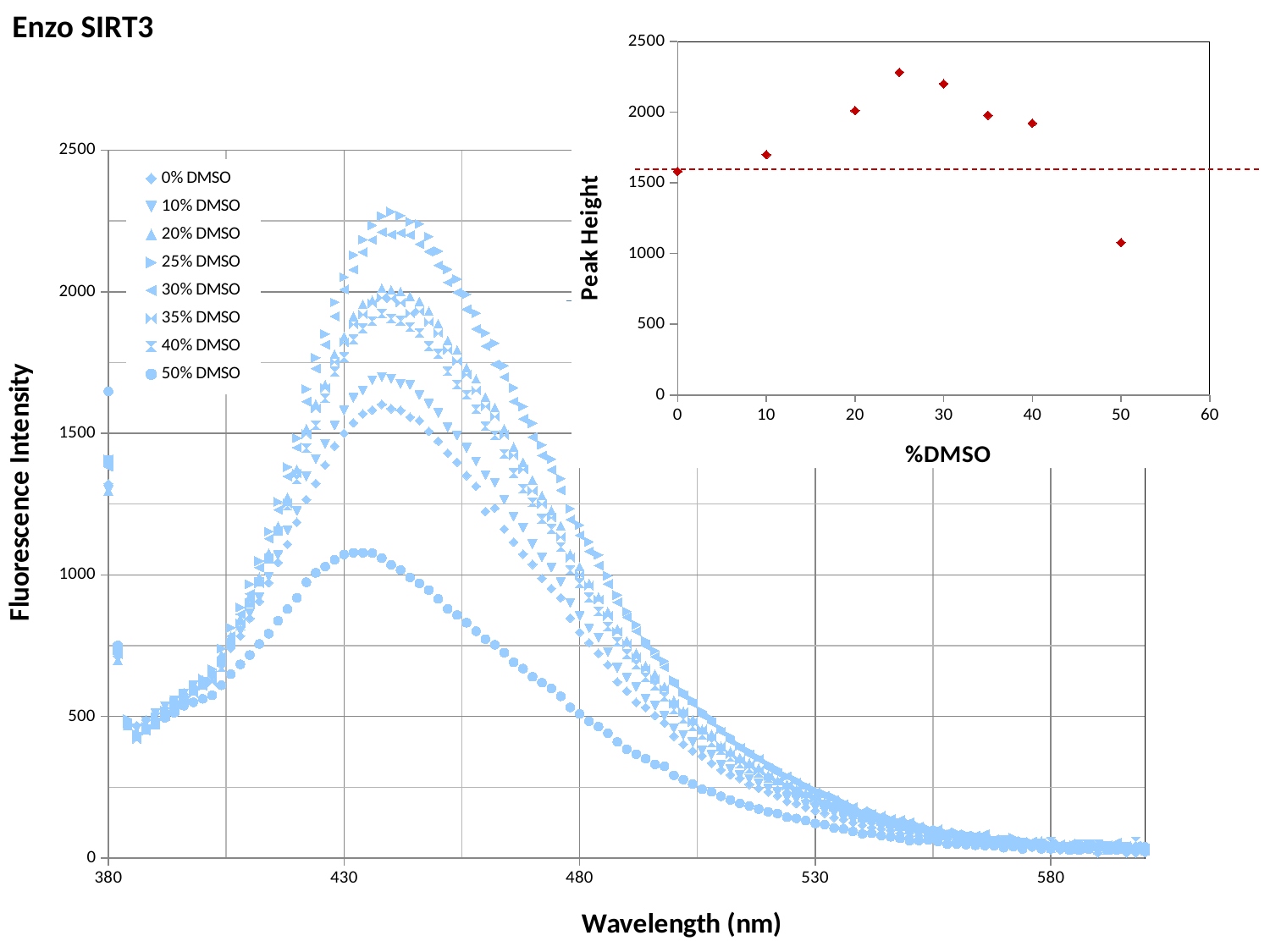
In the large fluorescence chart, which series has the lowest peak fluorescence intensity? 50% DMSO In the inset chart of Peak Height versus %DMSO, is the peak height at 25% DMSO greater or less than 2000? greater In the inset chart of Peak Height versus %DMSO, is the peak height at 50% DMSO greater or less than 1500? less In the inset chart of Peak Height versus %DMSO, which has the larger peak height: 10% DMSO or 30% DMSO? 30% DMSO In the large fluorescence chart, which series reaches the highest fluorescence intensity? 25% DMSO In the inset chart of Peak Height versus %DMSO, at which %DMSO is the peak height lowest? 50 In the inset chart of Peak Height versus %DMSO, is the peak height at 0% DMSO greater or less than 2000? less In the inset chart of Peak Height versus %DMSO, how many data points are plotted? 8 In the inset chart of Peak Height versus %DMSO, does the peak height rise or fall as %DMSO increases from 25 to 50? fall In the large fluorescence chart, what is the label of the x axis? Wavelength (nm) In the inset chart of Peak Height versus %DMSO, at which %DMSO is the peak height highest? 25 In the large fluorescence chart, how many series does the legend list? 8